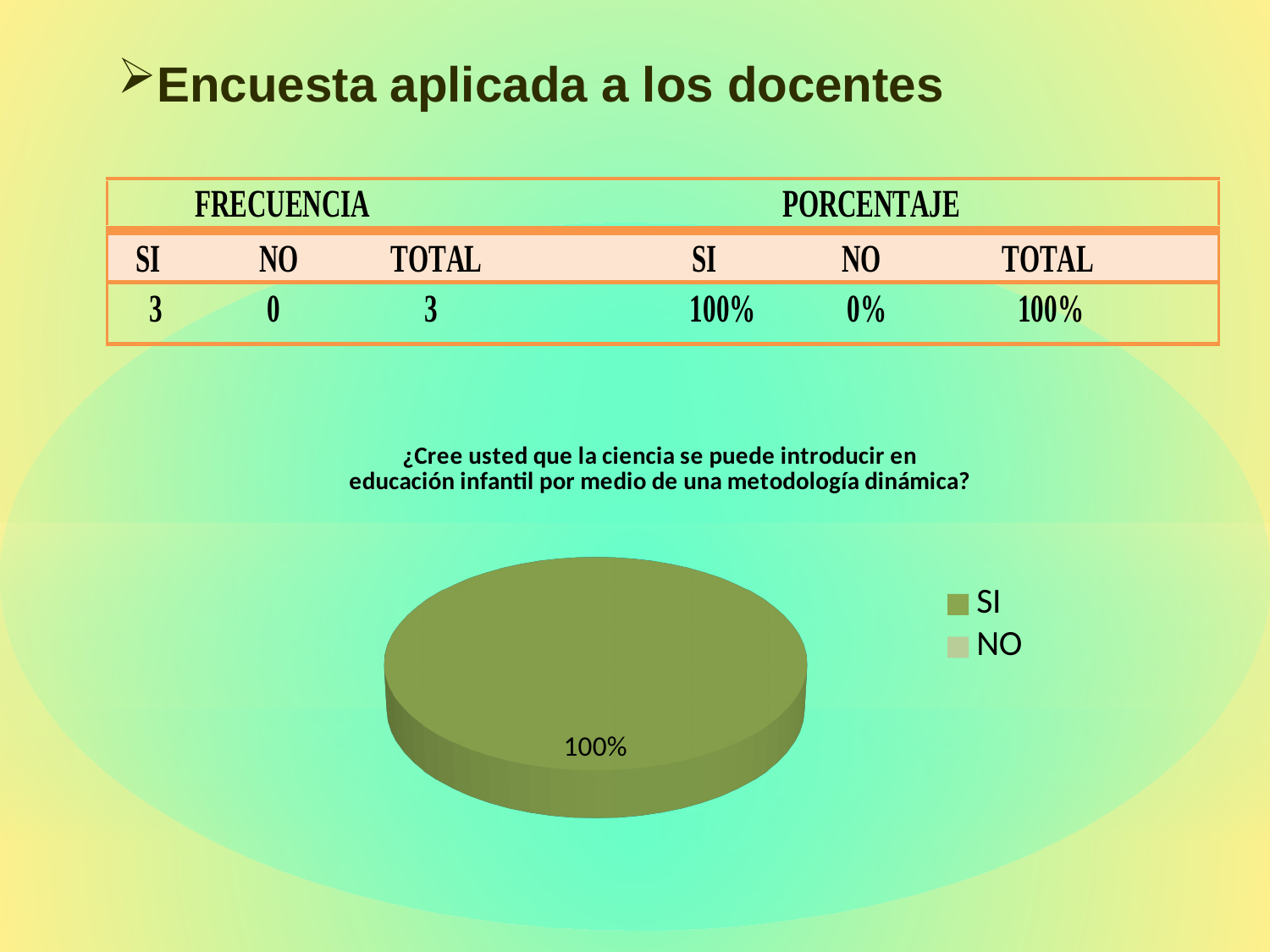
Is the share for SI in the pie chart greater or less than 50%? greater What share of the pie does the SI slice represent? 100% Which legend entry is shown in olive green in the pie chart? SI Which category has the smaller share in the pie chart, SI or NO? NO What kind of chart is shown on the slide? pie chart What percentage is shown on the pie chart's data label? 100% Which category makes up the entire pie chart? SI What is the title of the pie chart? ¿Cree usted que la ciencia se puede introducir en educación infantil por medio de una metodología dinámica? How many entries does the pie chart's legend list? 2